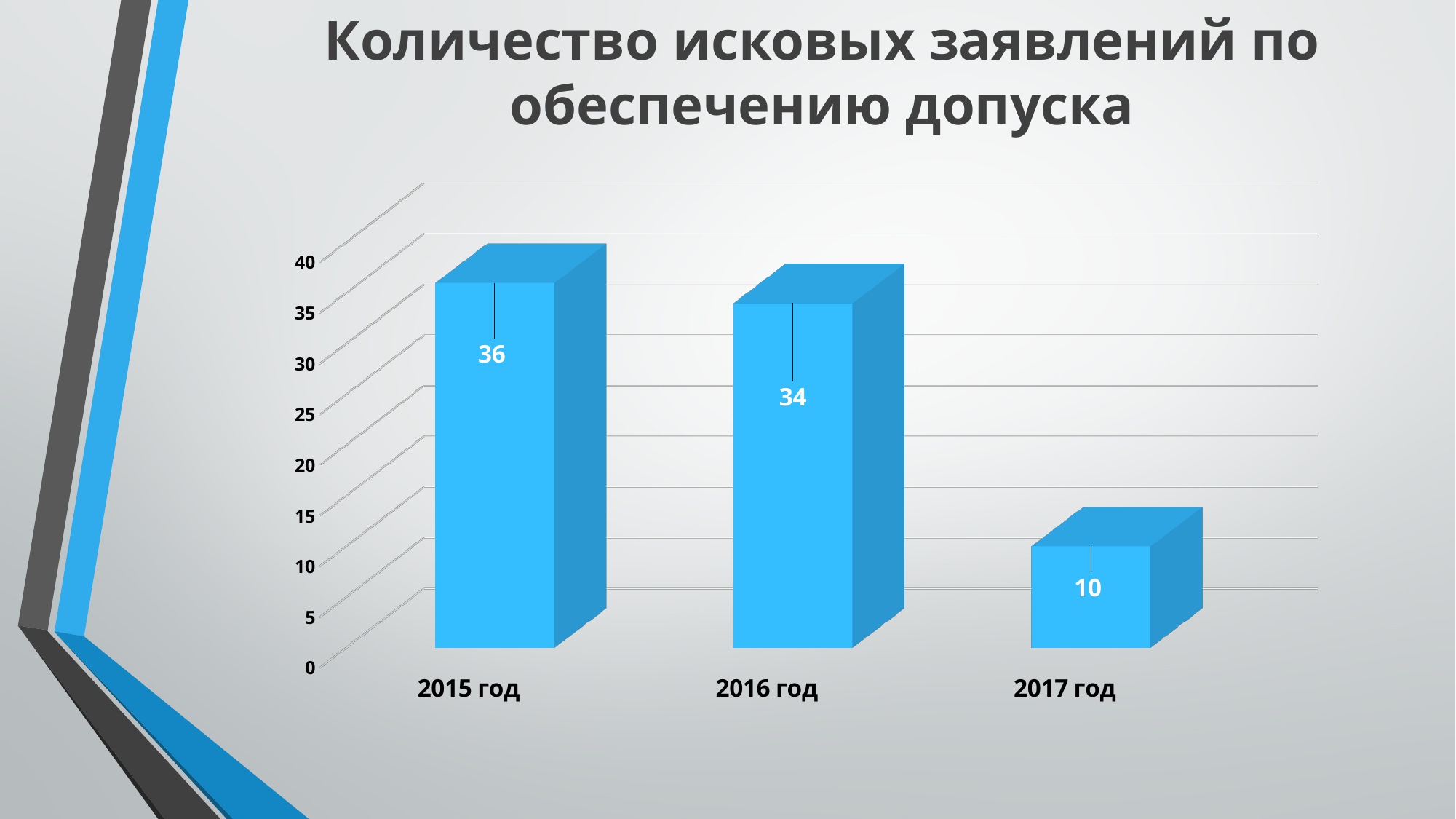
What is the value for 2016 год? 34 What is the difference between the values for 2015 год and 2016 год? 2 What kind of chart is shown on the slide? bar chart What is the value for 2015 год? 36 Which is larger, the value for 2016 год or the value for 2017 год? 2016 год Which year has the highest value? 2015 год Is the value for 2017 год greater or less than 15? less Which year has the lowest value? 2017 год What is the value for 2017 год? 10 Do the values rise or fall from 2015 год to 2017 год? fall How many categories are shown on the x axis? 3 What is the difference between the values for 2015 год and 2017 год? 26